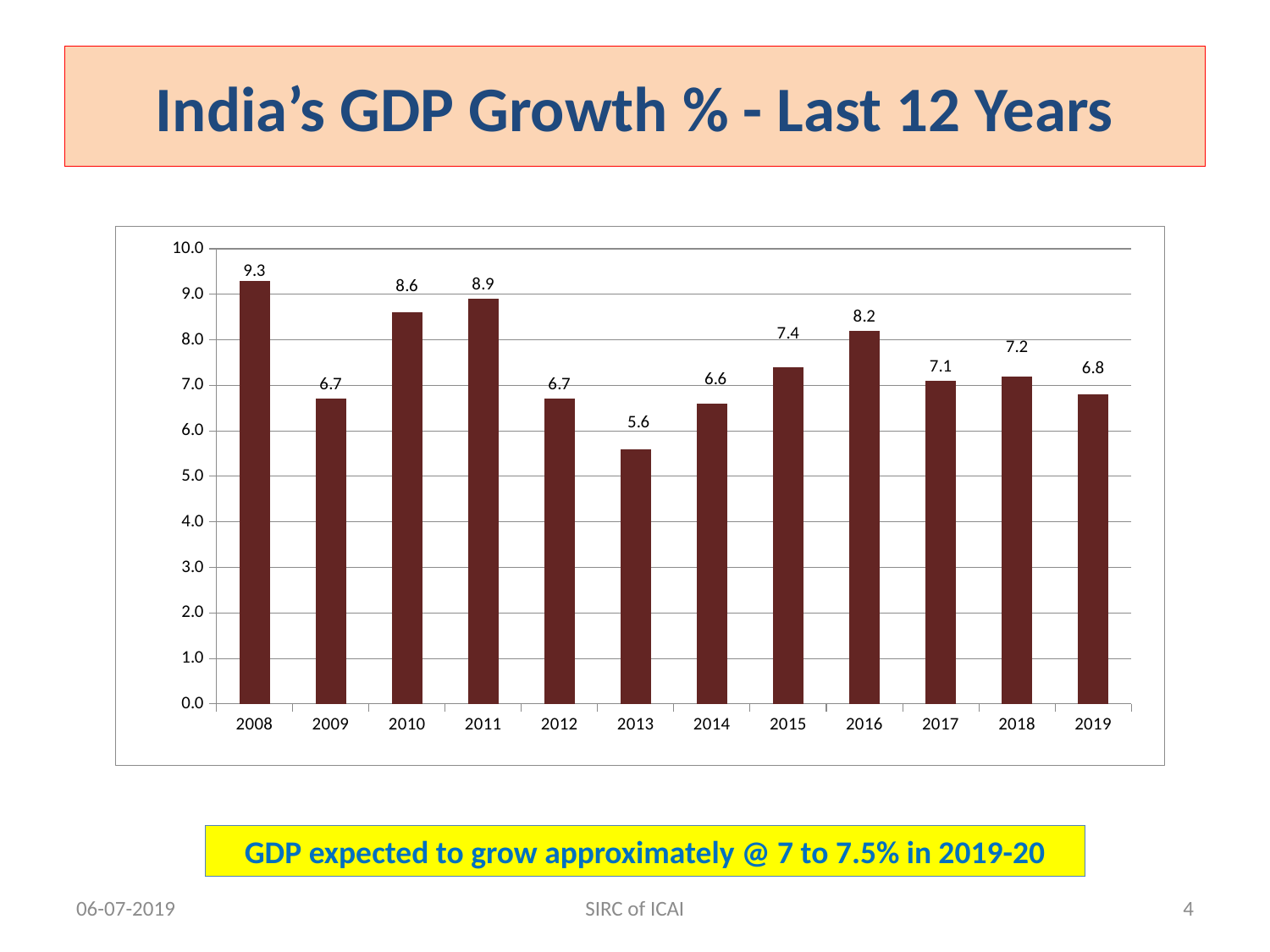
Which year has the larger GDP growth value, 2010 or 2015? 2010 Is the value for 2014 greater or less than 7.0? less Which year has the lowest GDP growth %? 2013 What kind of chart is shown on the slide? bar chart Do the GDP growth values rise or fall from 2013 to 2016? rise What is India's GDP growth % for 2008? 9.3 What is the GDP growth value shown for 2016? 8.2 Which year has the highest GDP growth %? 2008 What is the GDP growth value shown for 2013? 5.6 What is the title of the chart on the slide? India's GDP Growth % - Last 12 Years What is the difference between the GDP growth values for 2011 and 2012? 2.2 How many years are shown on the x axis of the chart? 12